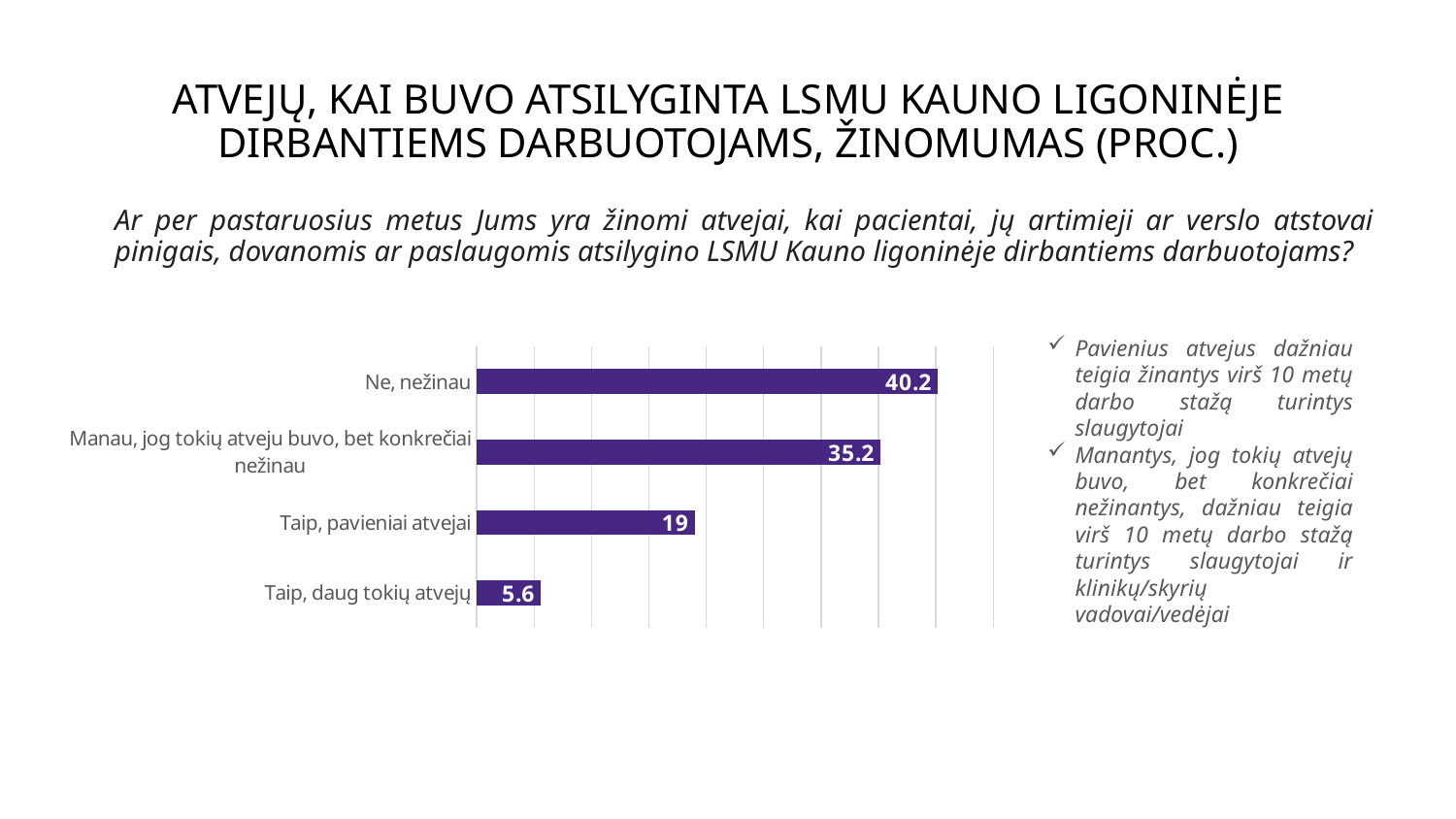
What is the difference between the values for "Taip, pavieniai atvejai" and "Taip, daug tokių atvejų"? 13.4 What is the difference between the values for "Ne, nežinau" and "Manau, jog tokių atveju buvo, bet konkrečiai nežinau"? 5 Which is larger: the value for "Taip, pavieniai atvejai" or the value for "Taip, daug tokių atvejų"? Taip, pavieniai atvejai What kind of chart is shown on the slide? Bar chart What is the value for "Manau, jog tokių atveju buvo, bet konkrečiai nežinau"? 35.2 What is the value for "Taip, pavieniai atvejai"? 19 How many categories are shown in the chart? 4 Which category has the lowest value? Taip, daug tokių atvejų Which category has the highest value? Ne, nežinau What colour are the bars in the chart? Purple What is the value for "Ne, nežinau"? 40.2 What is the value for "Taip, daug tokių atvejų"? 5.6